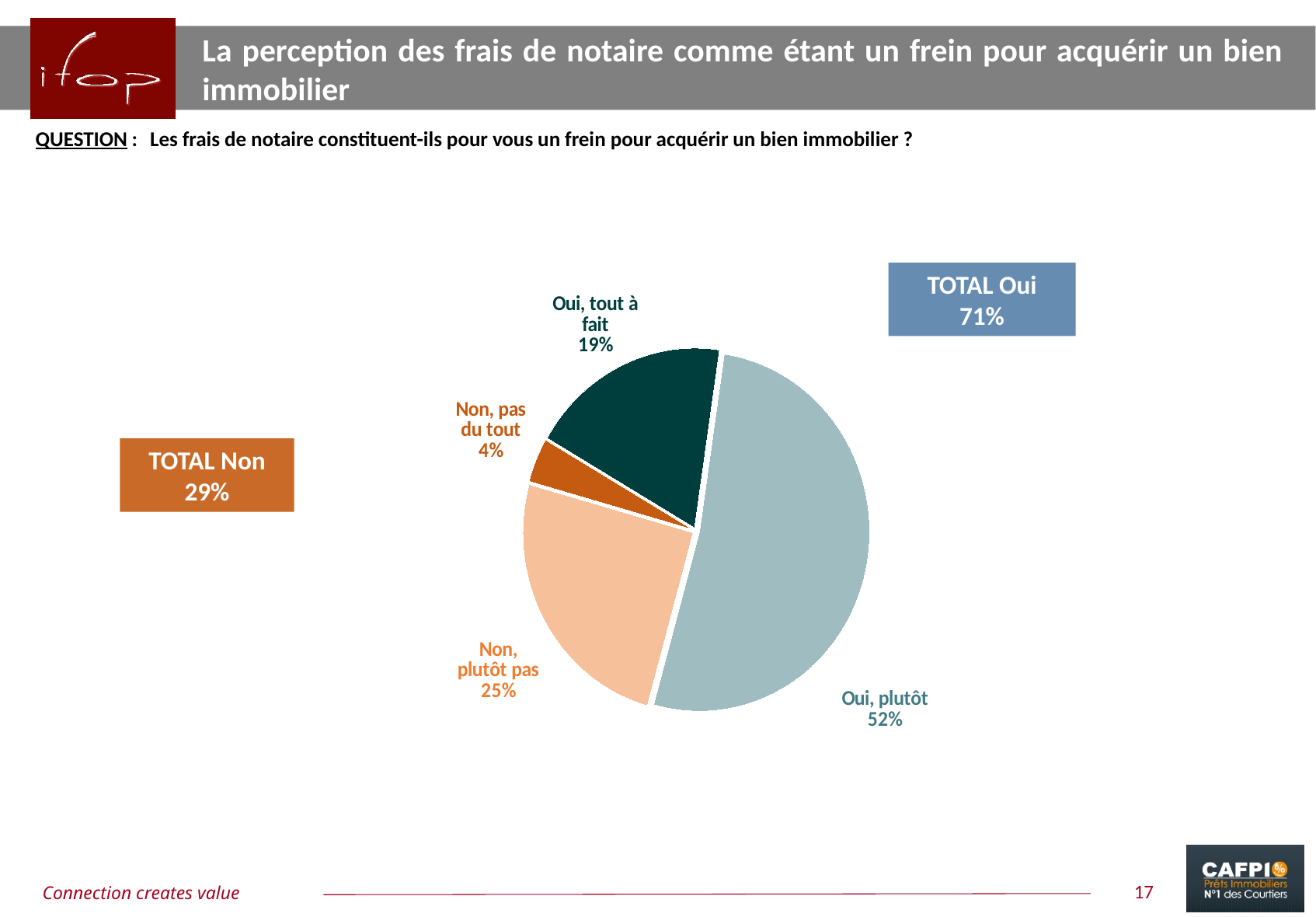
Which slice of the pie is the largest? Oui, plutôt What is the value for "Oui, tout à fait"? 19% Which is larger, "Oui, tout à fait" or "Non, plutôt pas"? Non, plutôt pas What is the value for "Oui, plutôt"? 52% What is the difference between "Oui, plutôt" and "Non, plutôt pas"? 27% How many slices does the pie chart have? 4 What is the value shown in the "TOTAL Non" box? 29% What kind of chart is shown on the slide? pie chart What is the value for "Non, plutôt pas"? 25% What is the value shown in the "TOTAL Oui" box? 71% Which slice of the pie is the smallest? Non, pas du tout What is the value for "Non, pas du tout"? 4%